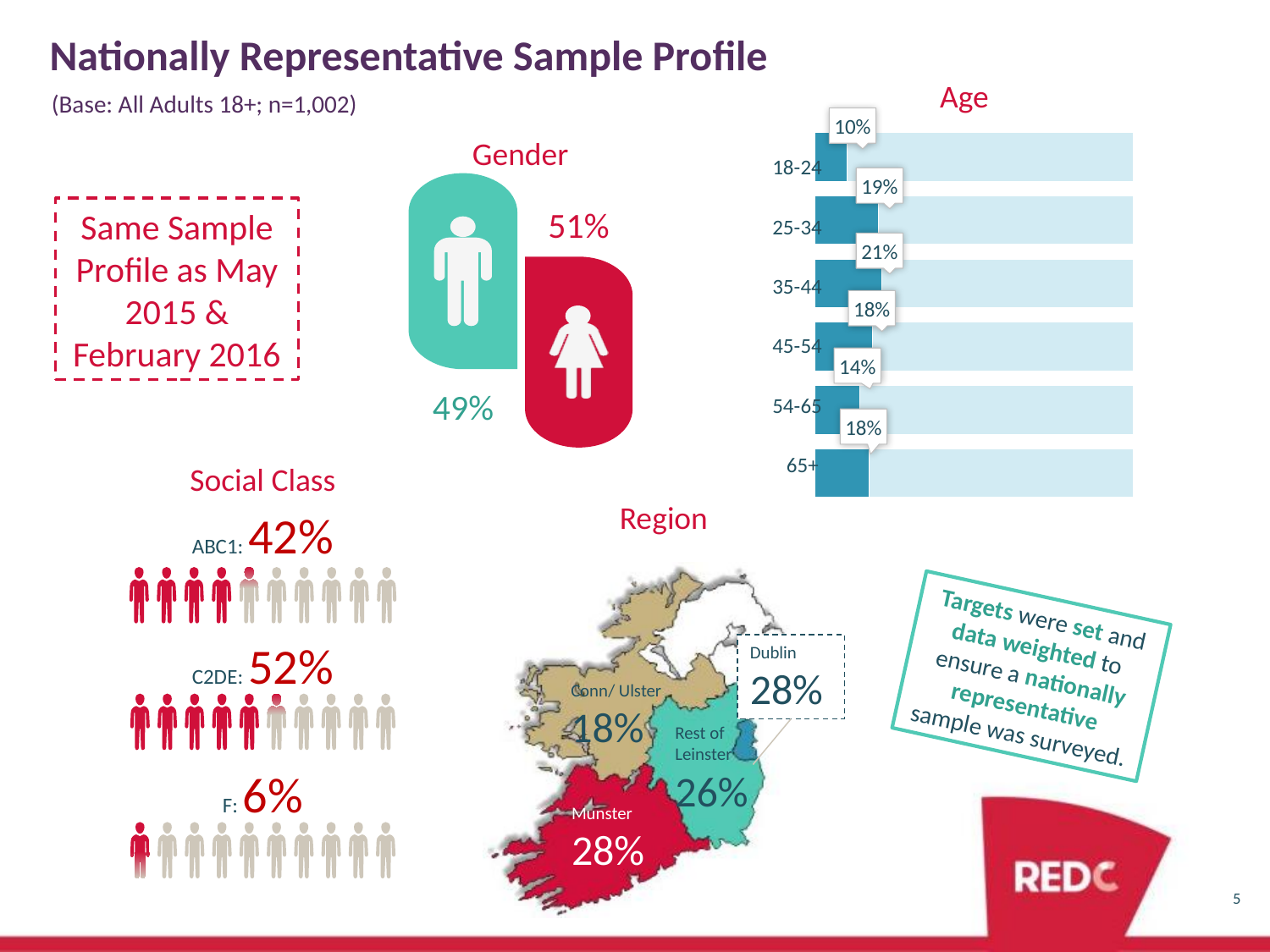
In the Age chart, which age group has the lowest share of the sample? 18-24 In the Region map, which region has the lowest share of the sample? Conn/ Ulster In the Age chart, what percentage of the sample is aged 18-24? 10% What type of chart is the Age chart? bar chart How many age groups are shown in the Age chart? 6 In the Age chart, what percentage of the sample is aged 54-65? 14% In the Age chart, which age group has the highest share of the sample? 35-44 In the Age chart, what is the combined share of the 45-54 and 65+ age groups? 36% In the Gender graphic, what percentage of the sample is female? 51% In the Age chart, which is larger: the share for 25-34 or the share for 54-65? 25-34 In the Age chart, what percentage of the sample is aged 35-44? 21% In the Age chart, what is the difference between the 35-44 share and the 18-24 share? 11%